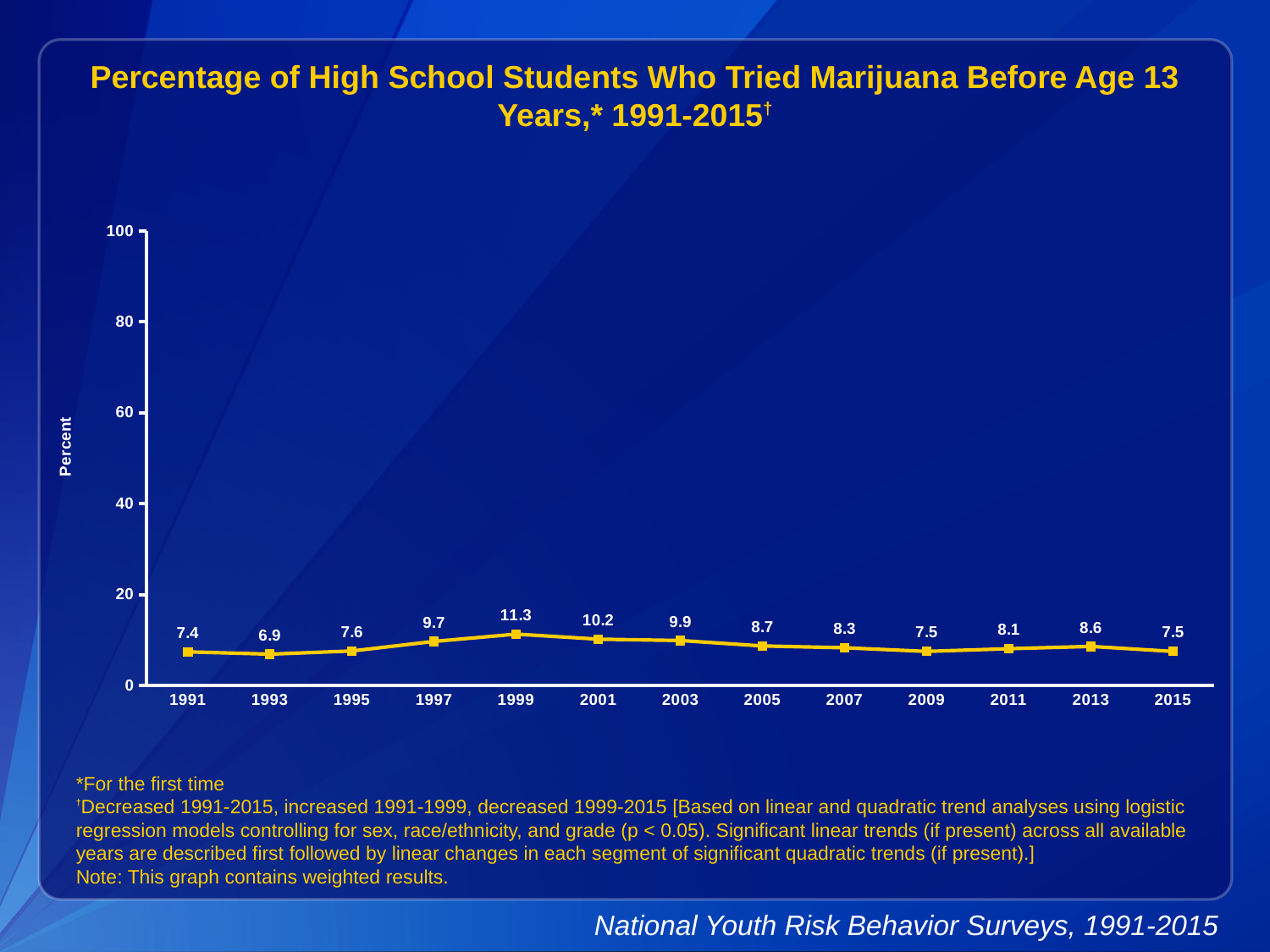
What is the value plotted for 2015? 7.5 What is the value plotted for 1991? 7.4 What percentage of high school students tried marijuana before age 13 in 1999? 11.3 What kind of chart is shown on the slide? line chart Do the values rise or fall from 1999 to 2009? fall Which year has the highest value on the chart? 1999 What is the difference between the values for 1999 and 2015? 3.8 What is the label on the y axis? Percent How many years are plotted on the x axis? 13 Is the value for 1997 greater or less than 20? less Which year has a larger value, 2001 or 2013? 2001 Which year has the lowest value on the chart? 1993